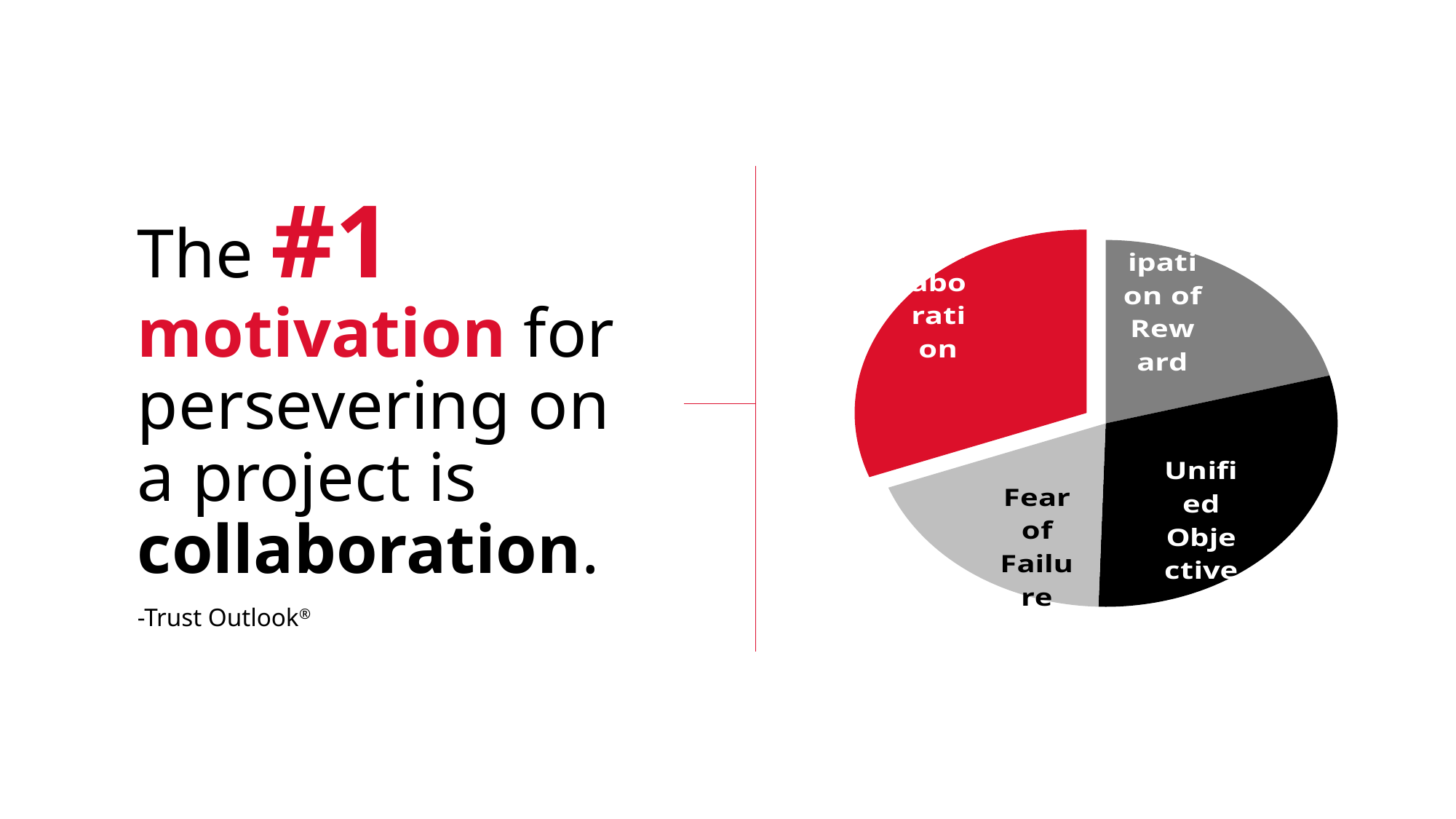
What colour is the Unified Objective slice in the pie chart? Black How many slices does the pie chart have? 4 Which is larger in the pie chart, the Collaboration slice or the Anticipation of Reward slice? Collaboration Which is larger in the pie chart, the Collaboration slice or the Fear of Failure slice? Collaboration Which slice of the pie chart is the largest? Collaboration What kind of chart is shown on the slide? Pie chart What colour is the Collaboration slice in the pie chart? Red Which is larger in the pie chart, the Collaboration slice or the Unified Objective slice? Collaboration